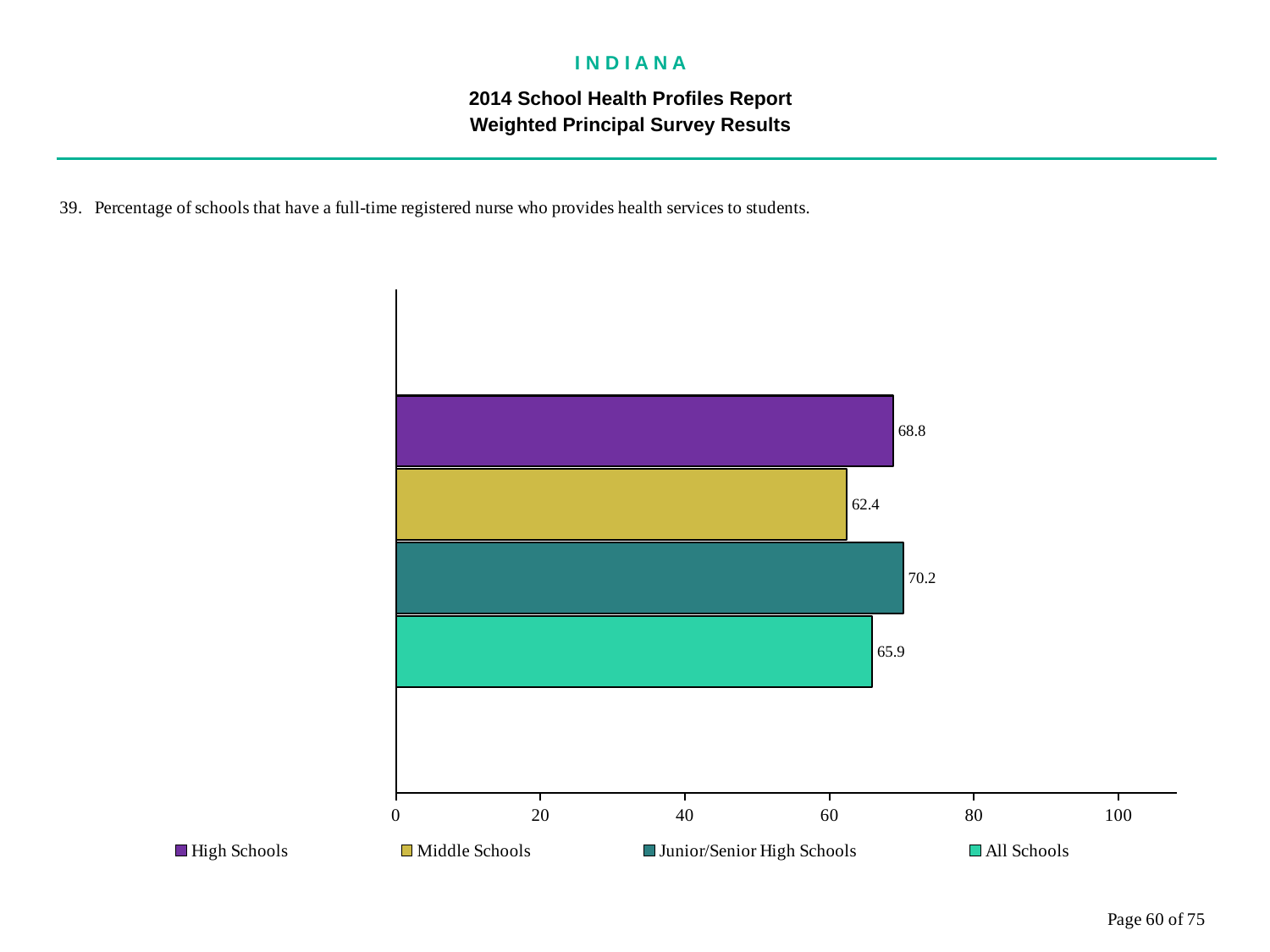
How many bars are shown in the chart? 4 What is the value for All Schools? 65.9 What is the value for Middle Schools? 62.4 What is the value for Junior/Senior High Schools? 70.2 Which school type has the highest value? Junior/Senior High Schools What kind of chart is shown on the slide? bar chart What is the value for High Schools? 68.8 Which is larger, the value for High Schools or the value for All Schools? High Schools What is the difference between the values for Junior/Senior High Schools and Middle Schools? 7.8 Which school type has the lowest value? Middle Schools How many entries does the legend list? 4 Is the value for Middle Schools greater or less than 60? greater